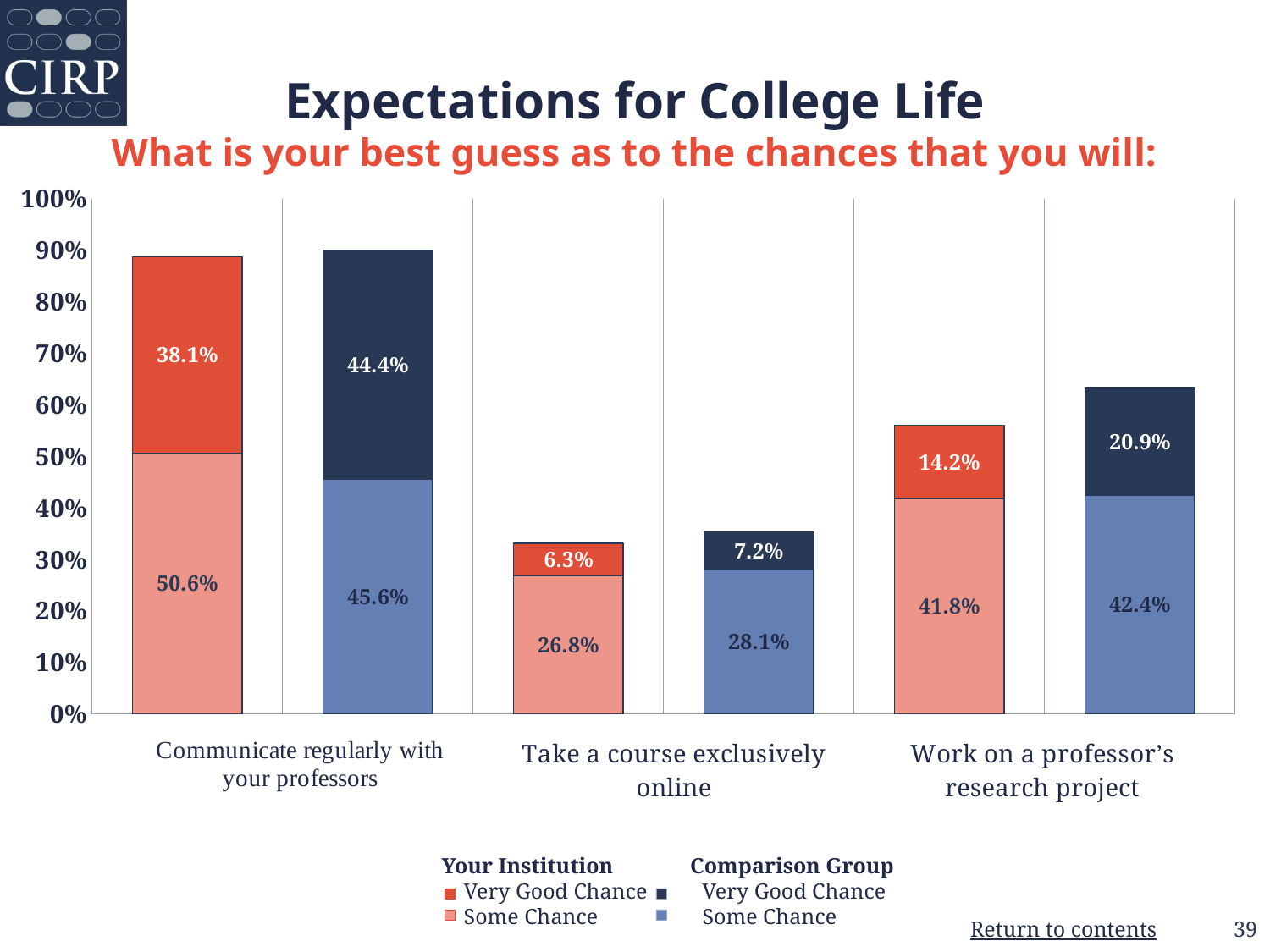
What kind of chart is shown on the slide? Stacked bar chart How many series does the legend list? 4 What is the total of the Comparison Group stacked bar for 'Communicate regularly with your professors'? 90.0% Which category has the highest 'Some Chance' value for the Comparison Group? Communicate regularly with your professors What is the total of the Your Institution stacked bar for 'Work on a professor's research project'? 56.0% Which category has the lowest 'Very Good Chance' value for Your Institution? Take a course exclusively online What is the 'Very Good Chance' value for the Comparison Group for 'Work on a professor's research project'? 20.9% For 'Communicate regularly with your professors', which is larger: the Your Institution 'Very Good Chance' value or the Comparison Group 'Very Good Chance' value? Comparison Group What is the difference between the Comparison Group and Your Institution 'Very Good Chance' values for 'Work on a professor's research project'? 6.7% What is the 'Some Chance' value for the Comparison Group for 'Take a course exclusively online'? 28.1% What is the 'Very Good Chance' value for Your Institution for 'Communicate regularly with your professors'? 38.1% How many categories are shown on the x axis of the chart? 3